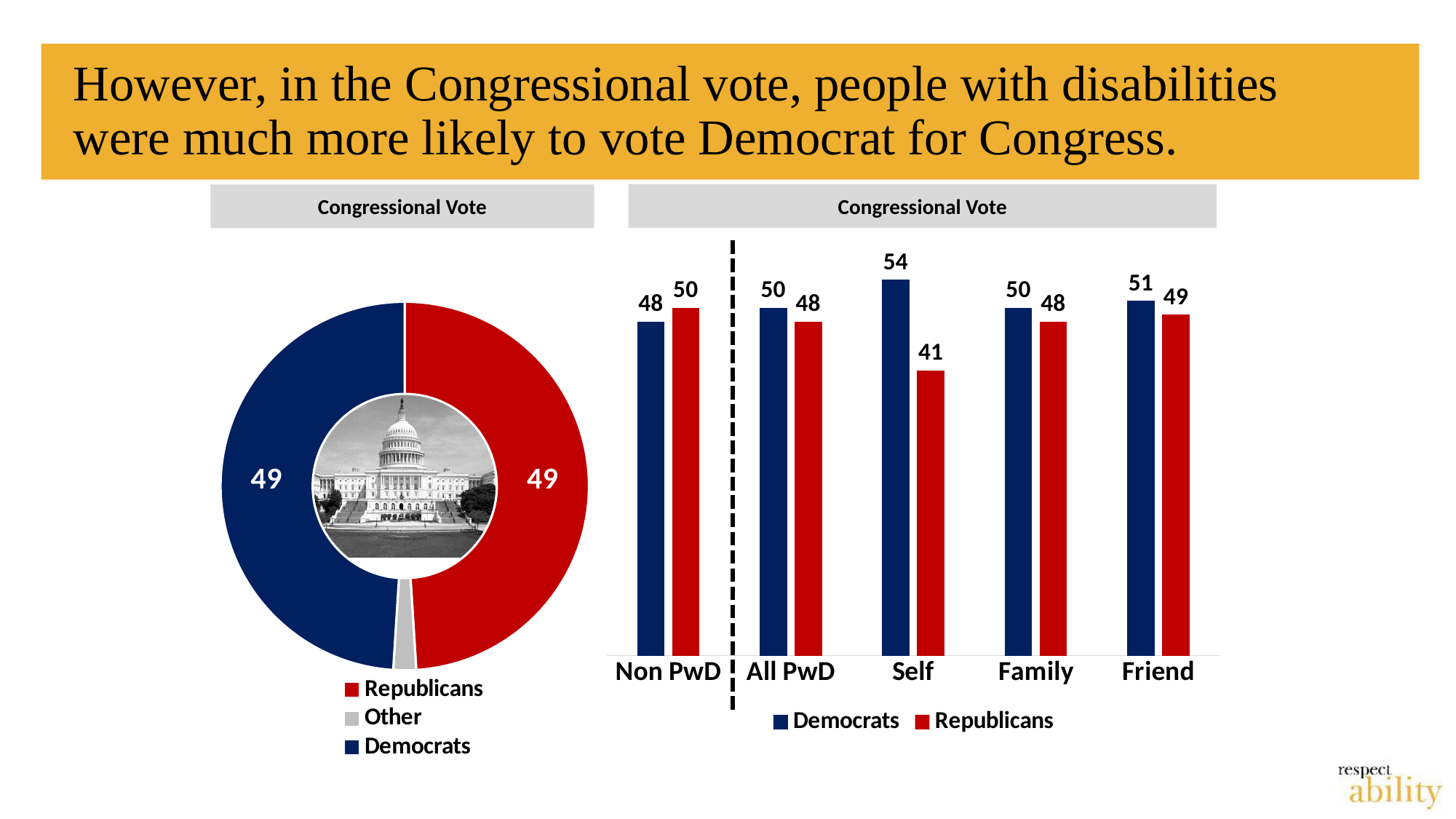
How many entries does the legend of the doughnut chart on the left list? 3 In the bar chart on the right, what is the difference between the Democrats and Republicans values in the Self category? 13 In the bar chart on the right, what is the value for Republicans in the Self category? 41 What kind of chart is the chart on the left of the slide? Doughnut (pie) chart How many categories are shown on the x axis of the bar chart on the right? 5 In the bar chart on the right, which is larger in the Friend category, Democrats or Republicans? Democrats In the bar chart on the right, which category has the lowest Republicans value? Self In the bar chart on the right, what is the value for Democrats in the Self category? 54 In the doughnut chart on the left, what is the value shown for Democrats? 49 In the bar chart on the right, which category has the highest Democrats value? Self How many series does the legend of the bar chart on the right list? 2 In the bar chart on the right, what is the value for Republicans in the Non PwD category? 50